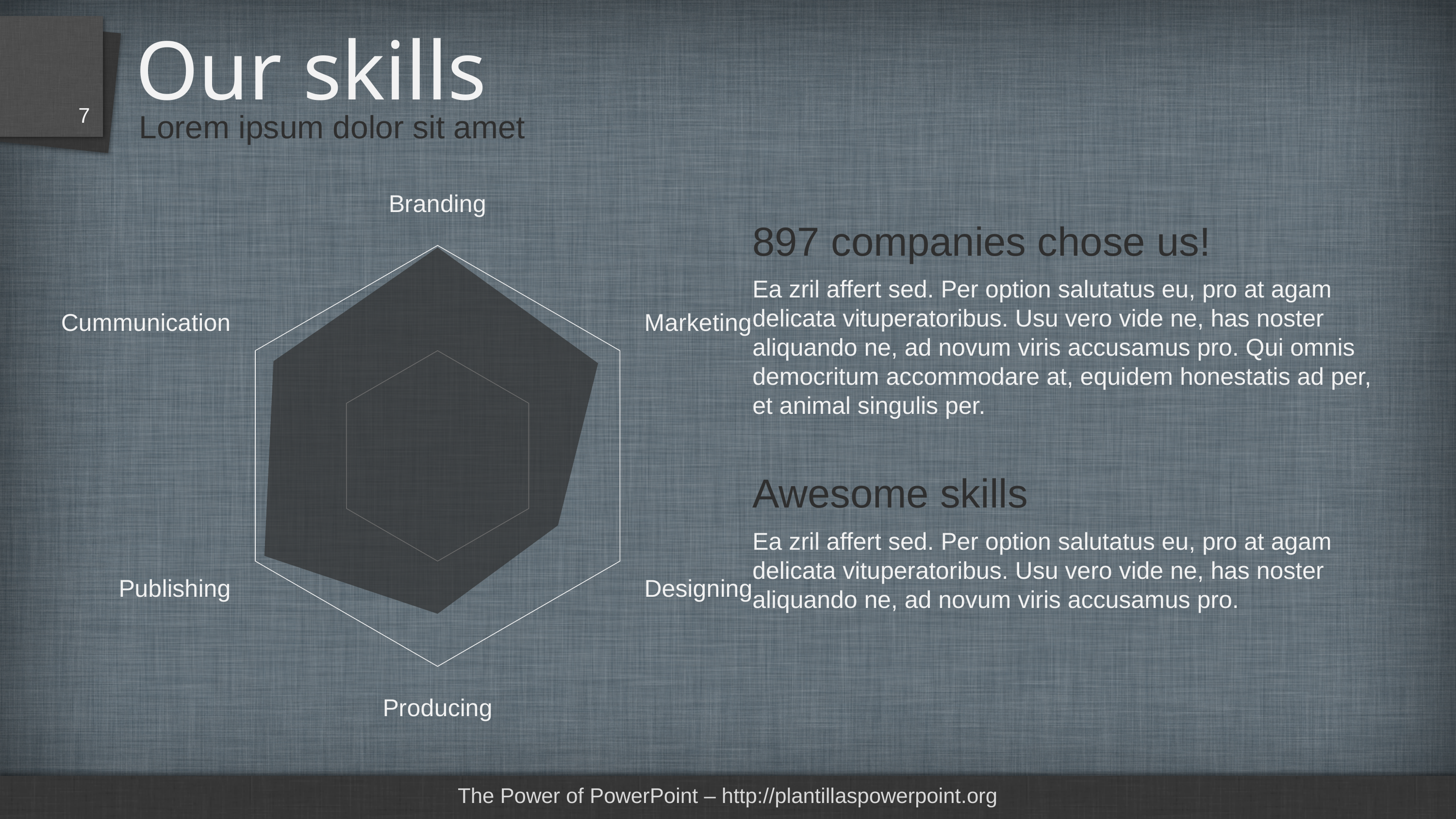
Which category has the highest value on the radar chart? Branding What kind of chart is shown on the slide? radar chart Which category label appears at the bottom of the radar chart? Producing Which has the larger value on the radar chart, Branding or Designing? Branding Which category has the lowest value on the radar chart? Designing Which has the larger value on the radar chart, Cummunication or Designing? Cummunication How many categories (axes) does the radar chart have? 6 Which category label appears at the top of the radar chart? Branding